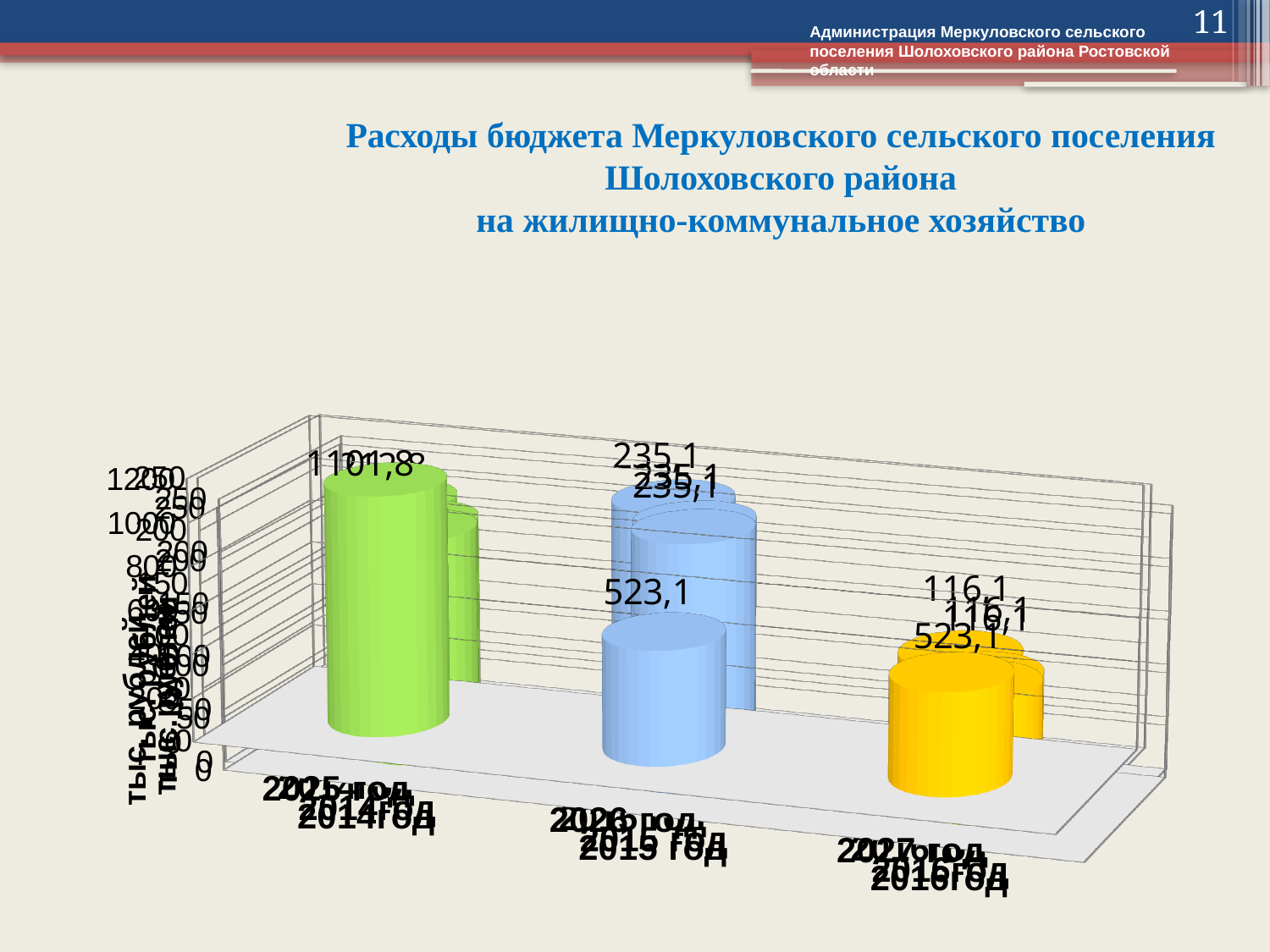
Is the green bar taller or shorter than the yellow bar? taller What kind of chart is shown on the slide? bar chart Which colour bar is the tallest in the chart? green Is the blue bar taller or shorter than the green bar? shorter What is the title of the chart on the slide? Расходы бюджета Меркуловского сельского поселения Шолоховского района на жилищно-коммунальное хозяйство How many different bar colours appear in the chart? 3